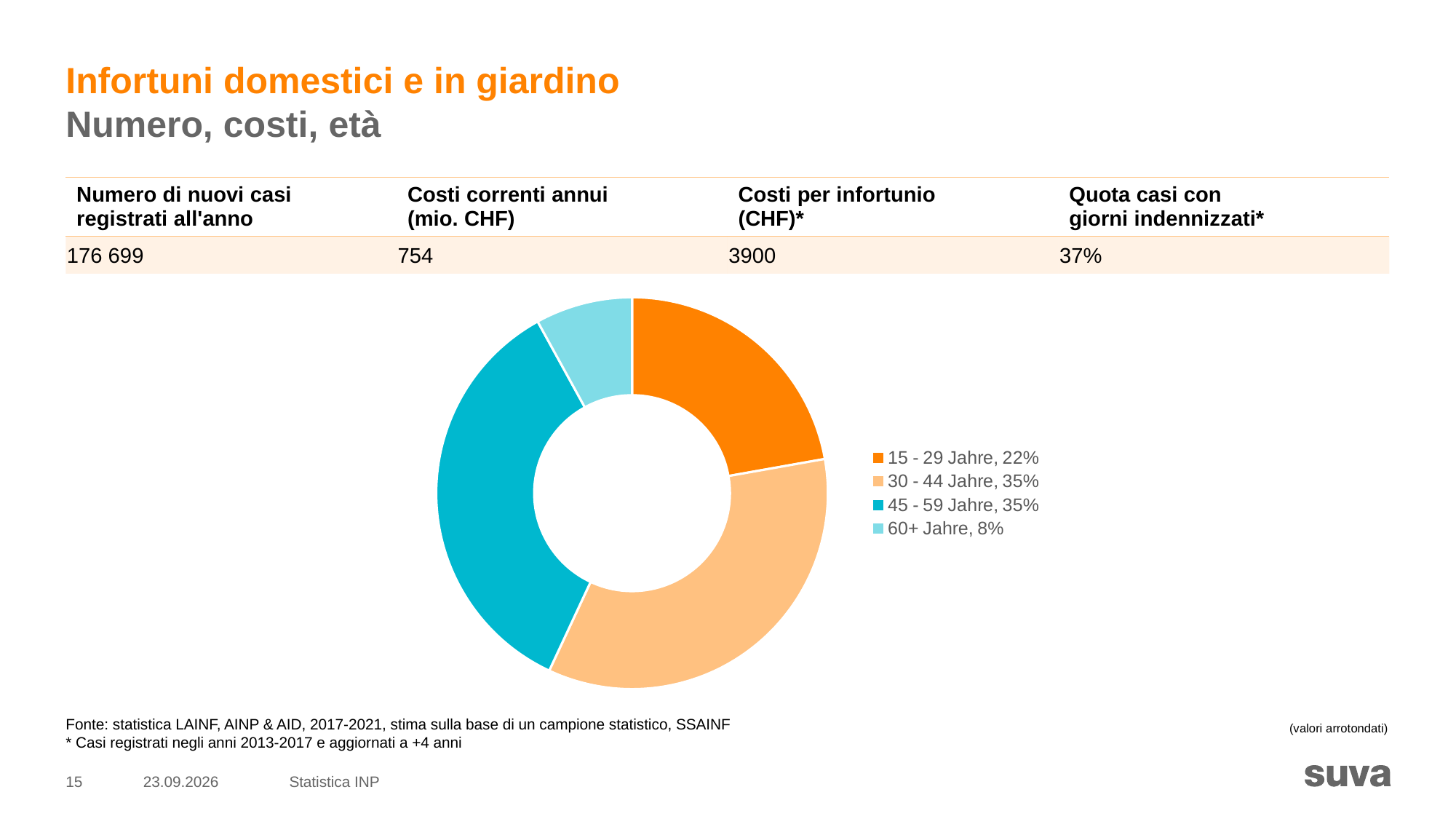
What kind of chart is shown on the slide? Doughnut (pie) chart Which slice is larger, 15 - 29 Jahre or 60+ Jahre? 15 - 29 Jahre Which colour represents the 45 - 59 Jahre category in the chart? Teal (dark cyan) Which age group has the smallest slice in the chart? 60+ Jahre What share of the doughnut chart does the 15 - 29 Jahre slice represent? 22% What is the difference in percentage points between the 15 - 29 Jahre slice and the 60+ Jahre slice? 14 percentage points What is the difference in percentage points between the 45 - 59 Jahre slice and the 15 - 29 Jahre slice? 13 percentage points What percentage is shown for the 30 - 44 Jahre category in the chart? 35% What is the share of the 60+ Jahre slice in the chart? 8% How many age categories are shown in the chart? 4 What percentage is shown for the 45 - 59 Jahre category in the chart? 35% Which slice is larger, 30 - 44 Jahre or 15 - 29 Jahre? 30 - 44 Jahre